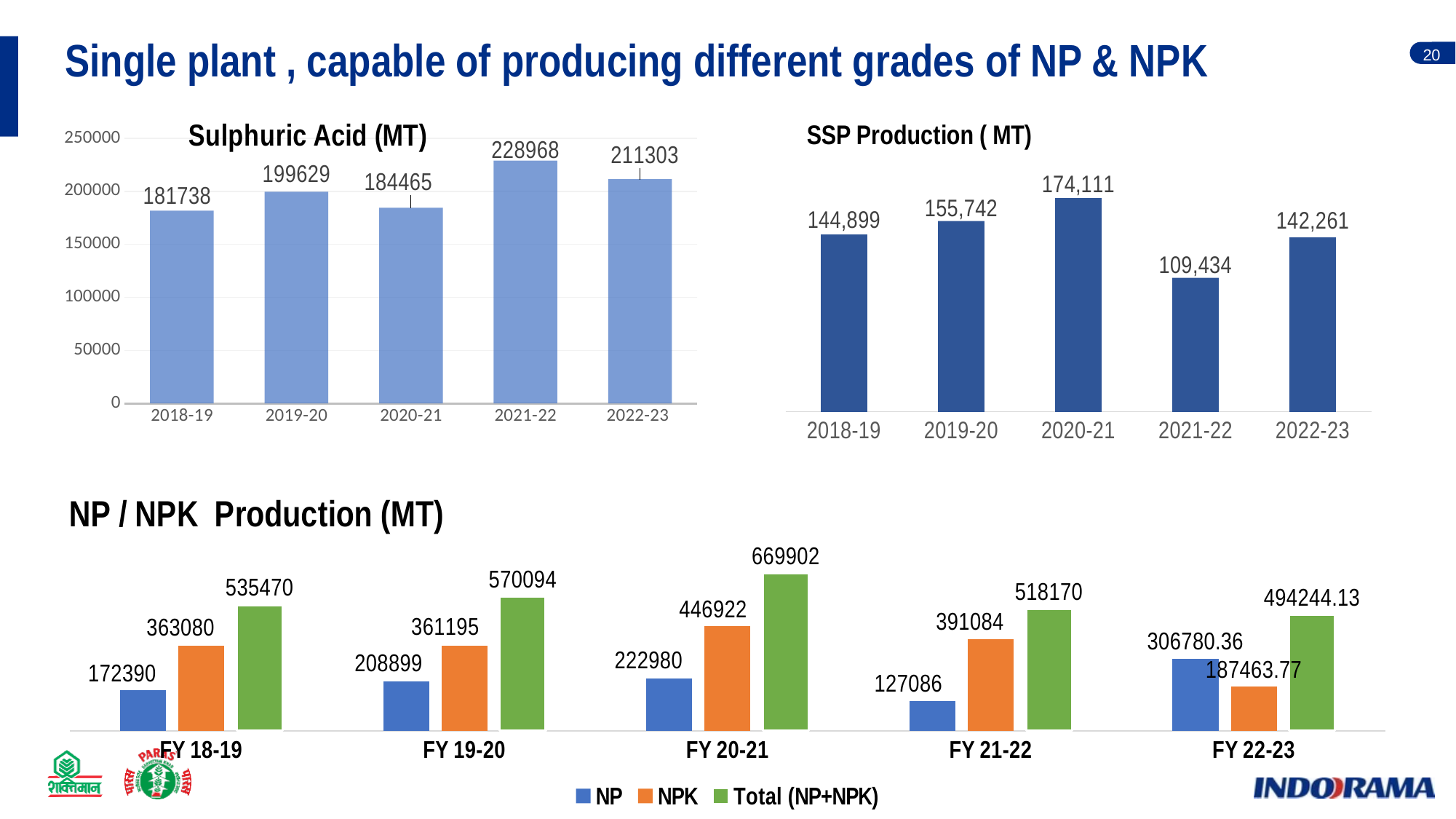
In the NP / NPK Production (MT) chart, how many series does the legend list? 3 In the Sulphuric Acid (MT) chart, what is the value for 2021-22? 228968 In the Sulphuric Acid (MT) chart, what is the difference between the 2021-22 and 2022-23 values? 17665 In the NP / NPK Production (MT) chart, what is the NPK value for FY 20-21? 446922 In the SSP Production ( MT) chart, what is the value for 2021-22? 109,434 What kind of chart is the Sulphuric Acid (MT) chart? bar chart In the Sulphuric Acid (MT) chart, which year has the lowest value? 2018-19 In the SSP Production ( MT) chart, which year has the highest value? 2020-21 In the NP / NPK Production (MT) chart, what is the Total (NP+NPK) value for FY 22-23? 494244.13 In the NP / NPK Production (MT) chart, which fiscal year has the highest Total (NP+NPK) value? FY 20-21 In the SSP Production ( MT) chart, is the value for 2019-20 larger or smaller than the value for 2022-23? larger In the Sulphuric Acid (MT) chart, how many years are shown? 5